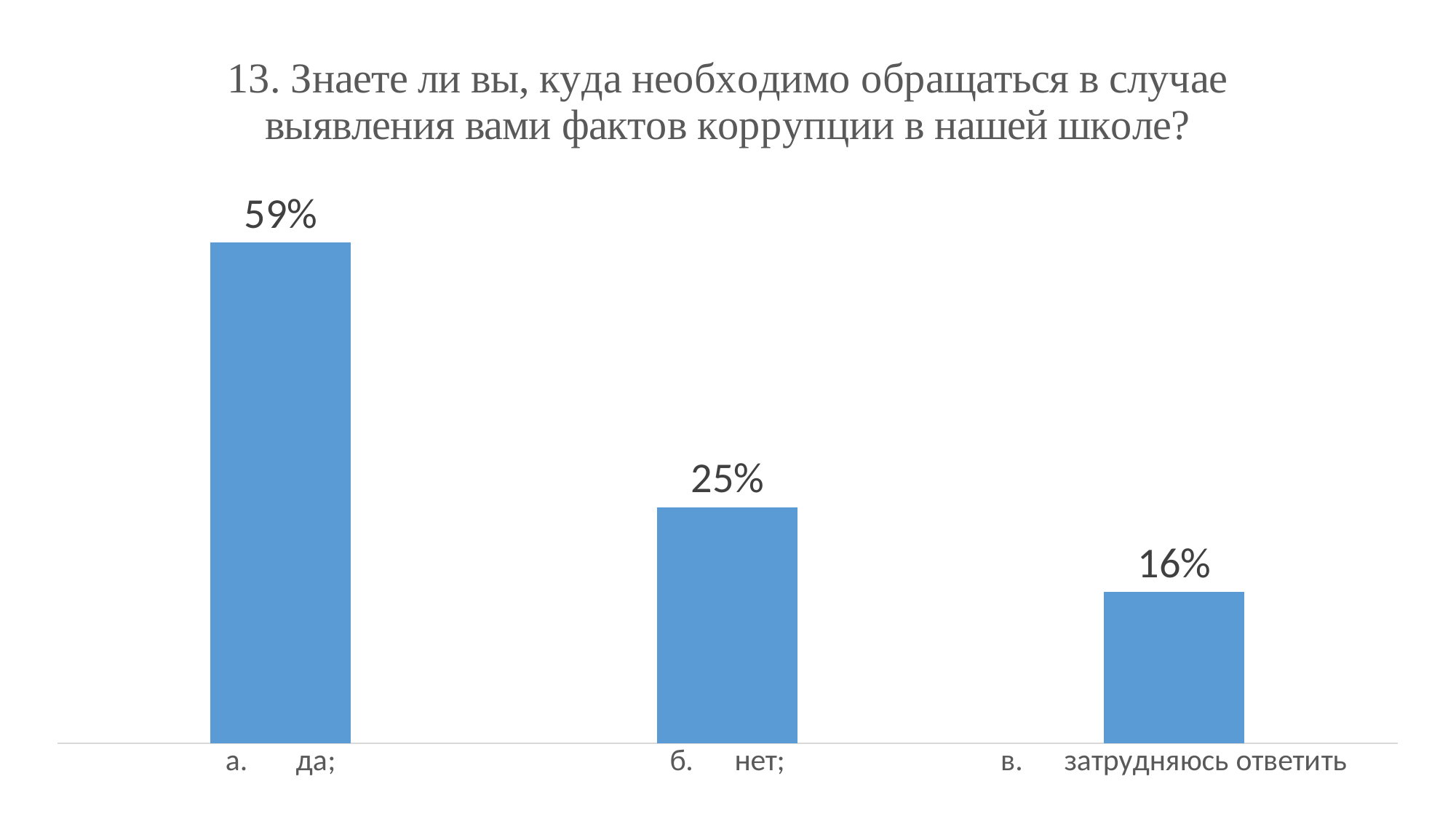
How many categories are shown in the chart? 3 What is the value for "да"? 59% What is the value for "затрудняюсь ответить"? 16% Which category has the highest value? да What is the difference between the values for "да" and "нет"? 34% Do the values rise or fall from left to right along the x axis? fall What is the value for "нет"? 25% What kind of chart is shown on the slide? bar chart What colour are the bars in the chart? blue What is the difference between the values for "нет" and "затрудняюсь ответить"? 9% Which category has the lowest value? затрудняюсь ответить Which is larger, the value for "нет" or the value for "затрудняюсь ответить"? нет